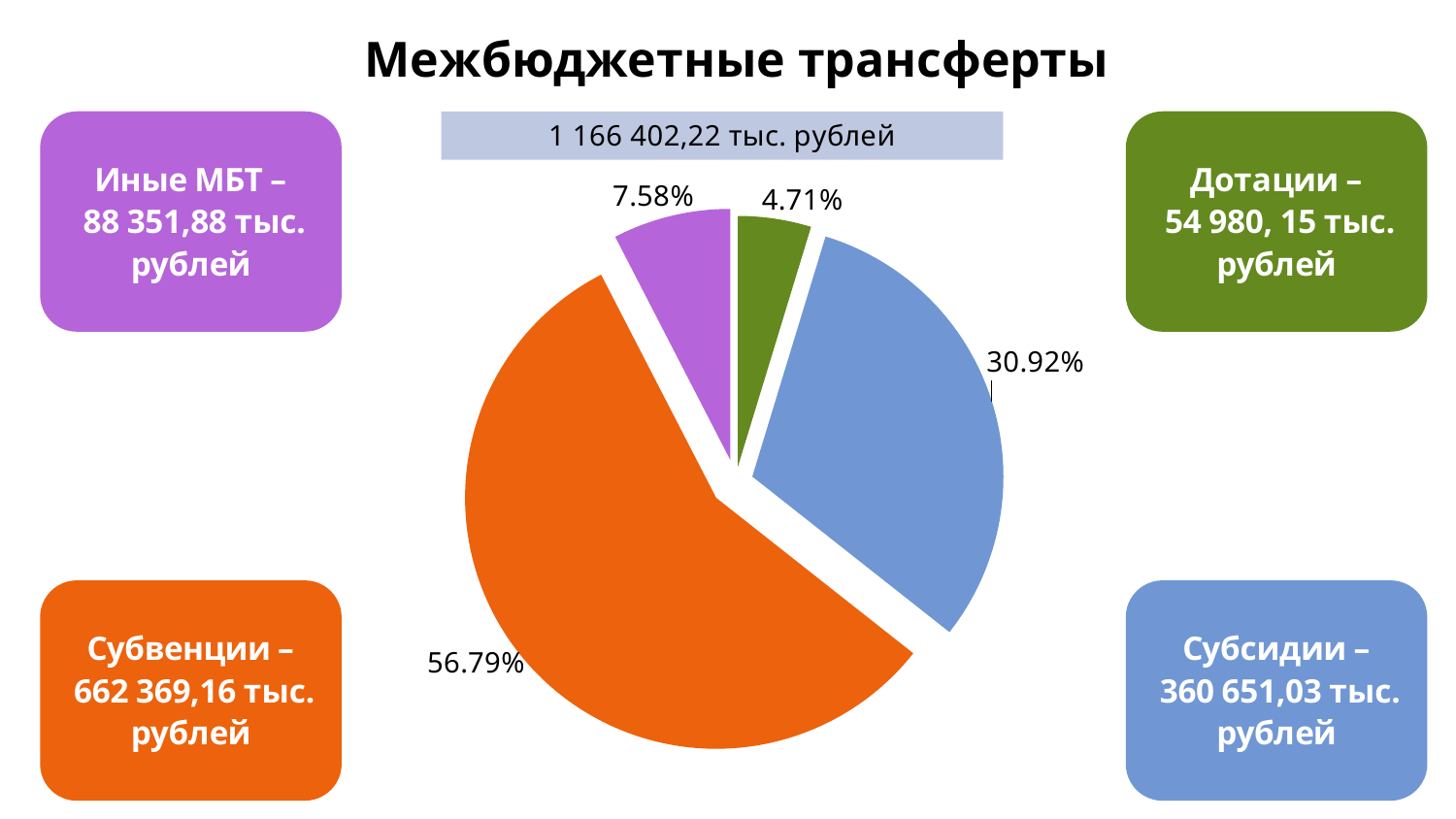
What is the total amount shown above the pie chart? 1 166 402,22 тыс. рублей How many slices does the pie chart have? 4 What share of the pie does Субсидии take? 30.92% Which category has the smallest slice of the pie? Дотации Which is larger, the share for Субсидии or the share for Иные МБТ? Субсидии What is the difference in percentage points between the Субвенции share and the Субсидии share? 25.87 What share of the pie does Дотации take? 4.71% What kind of chart is shown on the slide? pie chart What share of the pie does Субвенции take? 56.79% Which category has the largest slice of the pie? Субвенции What is the title of the chart? Межбюджетные трансферты